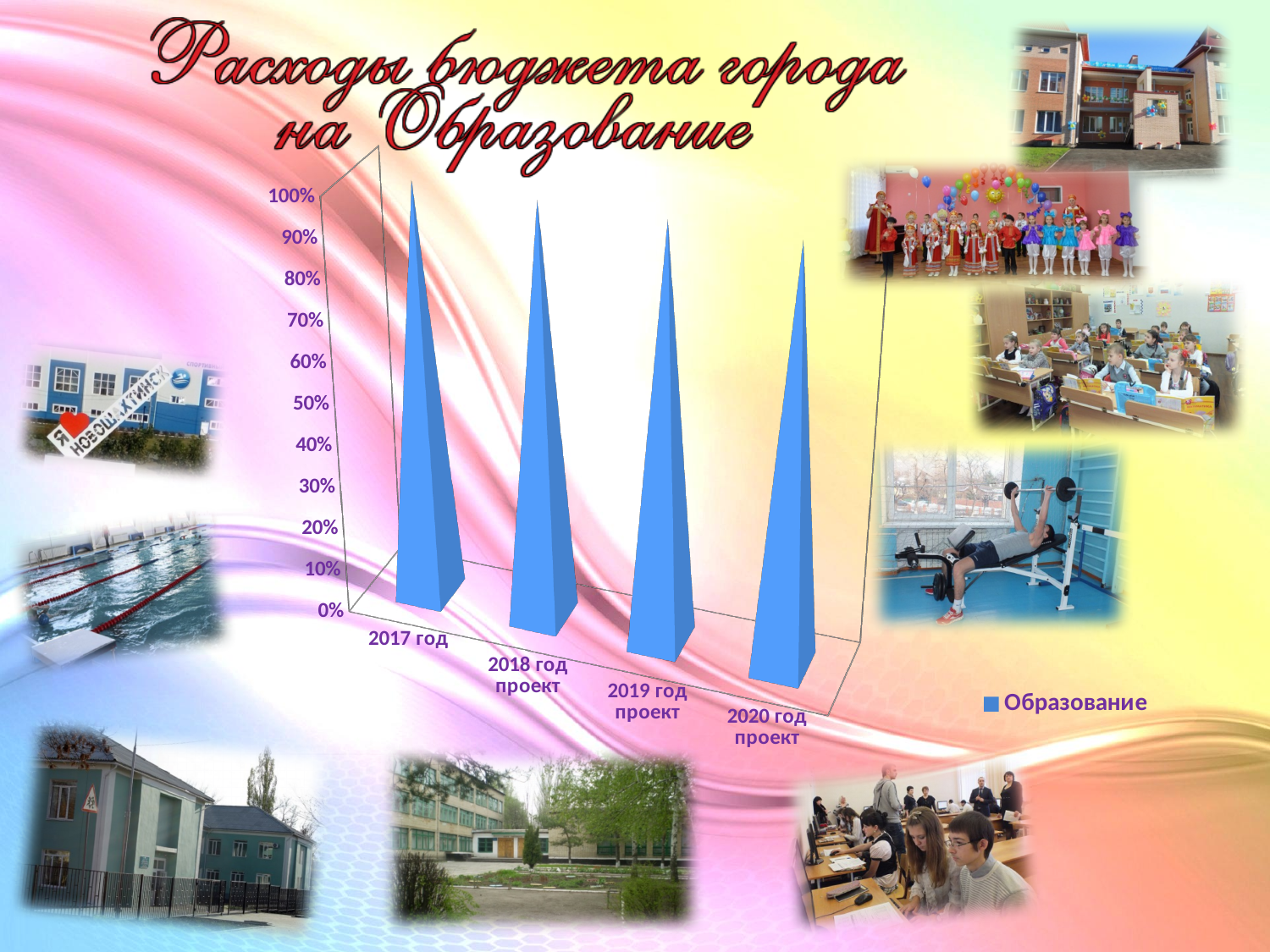
Is the value for 2020 год проект greater or less than 50%? greater How many categories are plotted along the x axis of the chart? 4 Is the value for 2018 год проект greater or less than 50%? greater What kind of chart is shown on the slide? bar chart What is the name of the series shown in the chart legend? Образование Is the value for 2017 год greater or less than 50%? greater What is the highest value shown on the chart's vertical axis? 100% What is the title of the slide above the chart? Расходы бюджета города на Образование How many series does the chart legend list? 1